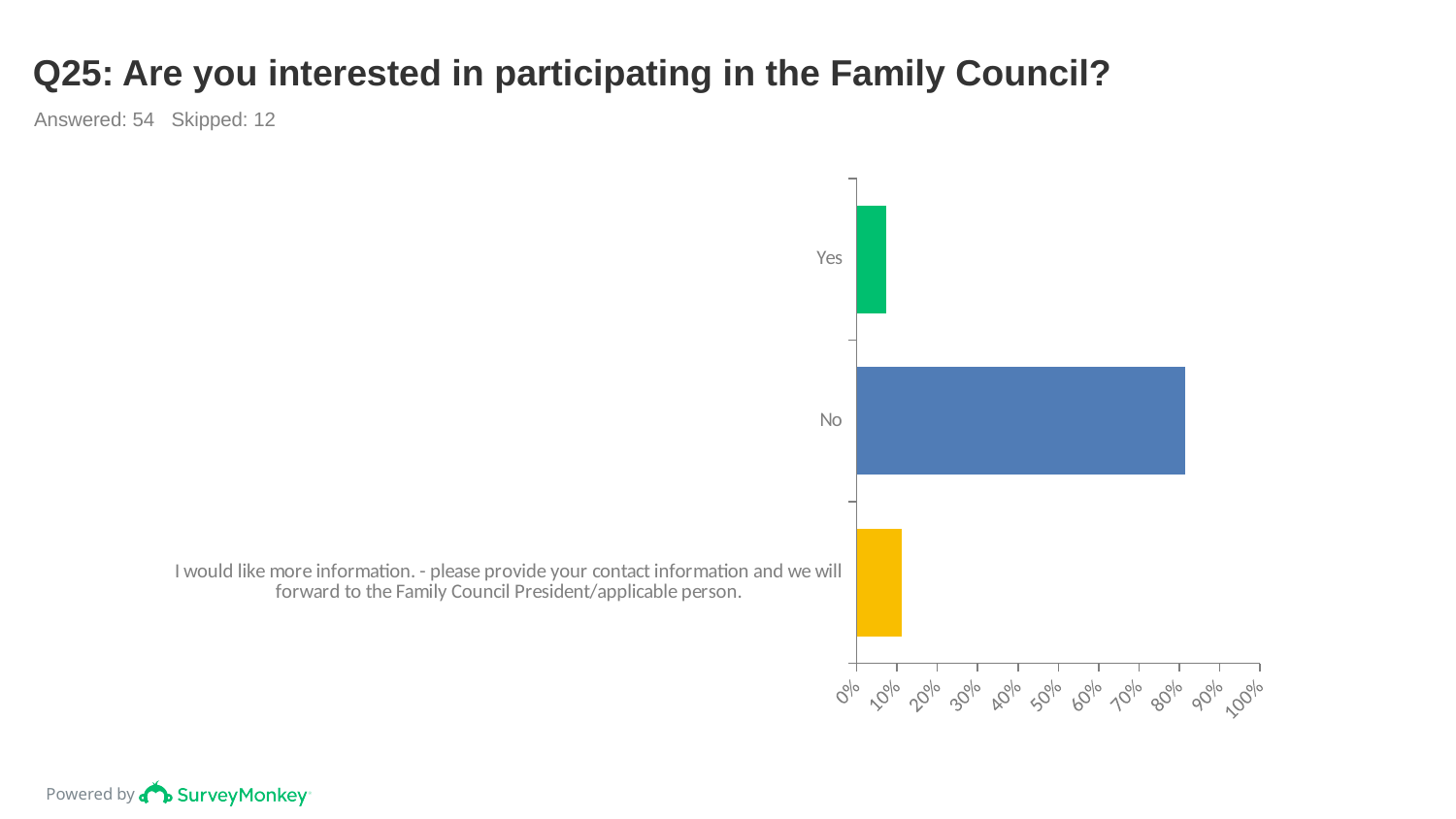
Which answer category has the lowest value? Yes Is the value for "I would like more information" greater or less than 20%? less What is the title of the chart? Q25: Are you interested in participating in the Family Council? Which answer category has the highest value? No Is the value for "Yes" greater or less than 10%? less Is the value for "No" greater or less than 90%? less How many answer categories are plotted in the chart? 3 What colour is the bar for "No"? blue Which has a larger value, "Yes" or "No"? No What kind of chart is shown on the slide? bar chart Which has a larger value, "Yes" or "I would like more information"? I would like more information